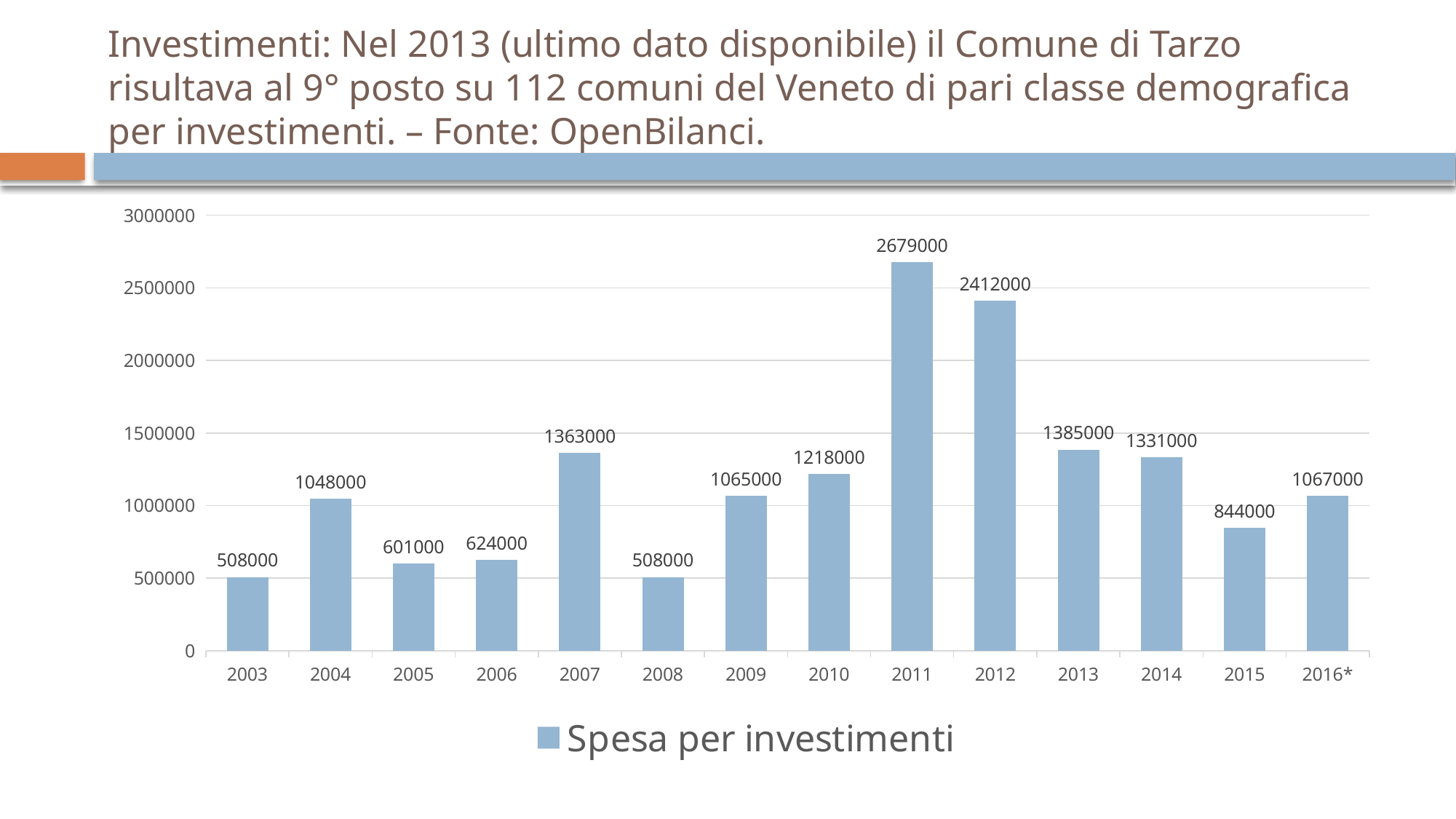
What kind of chart is shown on the slide? bar chart Is the value for 2015 greater or less than 1000000? less How many years are shown on the x axis? 14 Which is larger, the value for 2013 or the value for 2014? 2013 Which year has the highest Spesa per investimenti? 2011 What is the value of Spesa per investimenti for 2011? 2679000 What is the name of the series shown in the legend? Spesa per investimenti What is the difference between the values for 2011 and 2012? 267000 How many series does the legend list? 1 What is the value of Spesa per investimenti for 2007? 1363000 What is the value of Spesa per investimenti for 2016*? 1067000 Do the values rise or fall from 2011 to 2015? fall